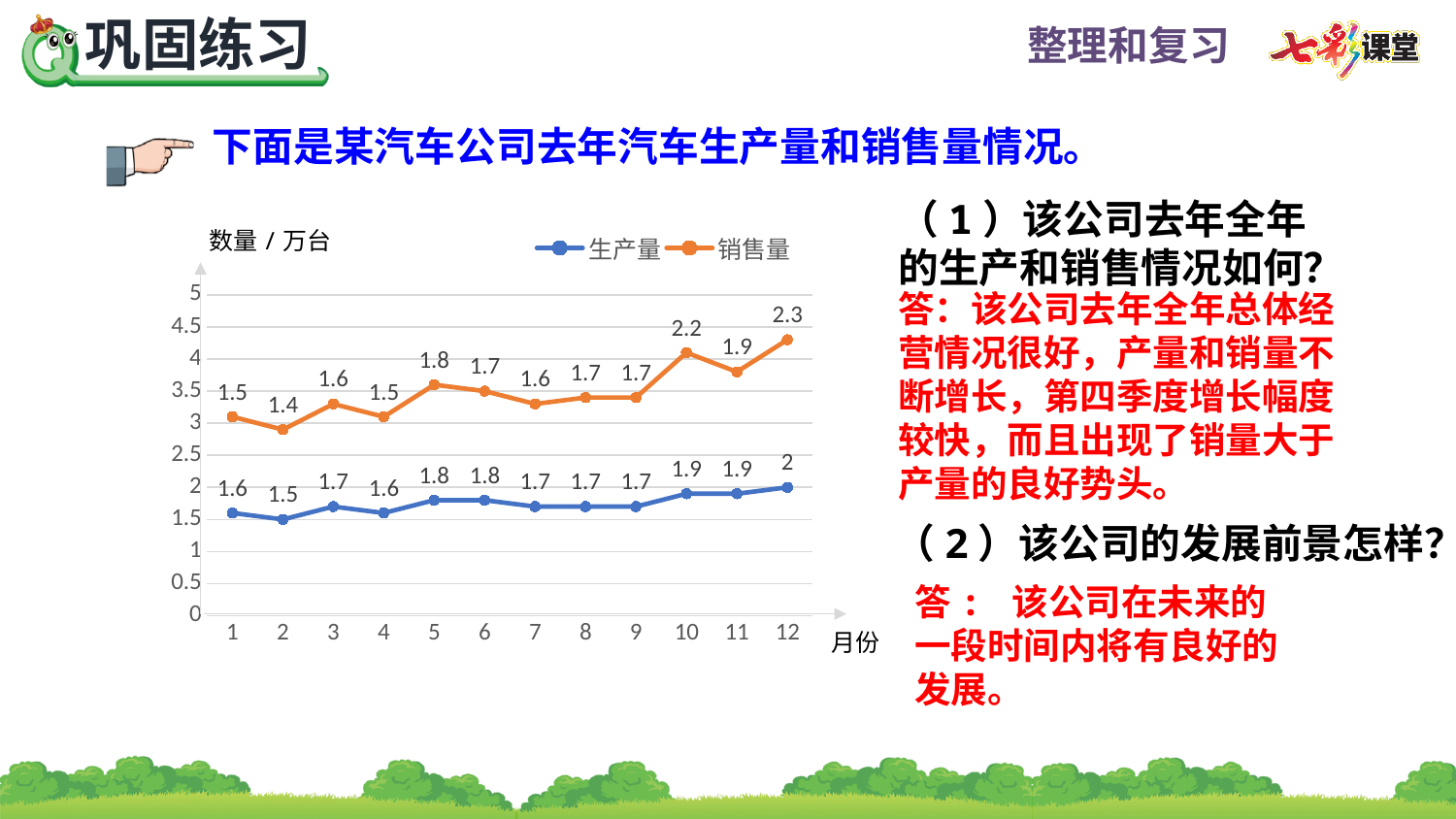
What kind of chart is shown? line chart What is the 销售量 value for month 1? 1.5 In which month is 生产量 lowest? 2 What is the 生产量 value for month 5? 1.8 What is the 销售量 value for month 10? 2.2 What is the unit label shown on the y axis? 数量 / 万台 How many months are plotted on the x axis? 12 What is the difference between 销售量 and 生产量 in month 12? 0.3 How many series does the legend list? 2 Which is larger in month 10, 生产量 or 销售量? 销售量 In which month is 销售量 lowest? 2 In which month is 销售量 highest? 12